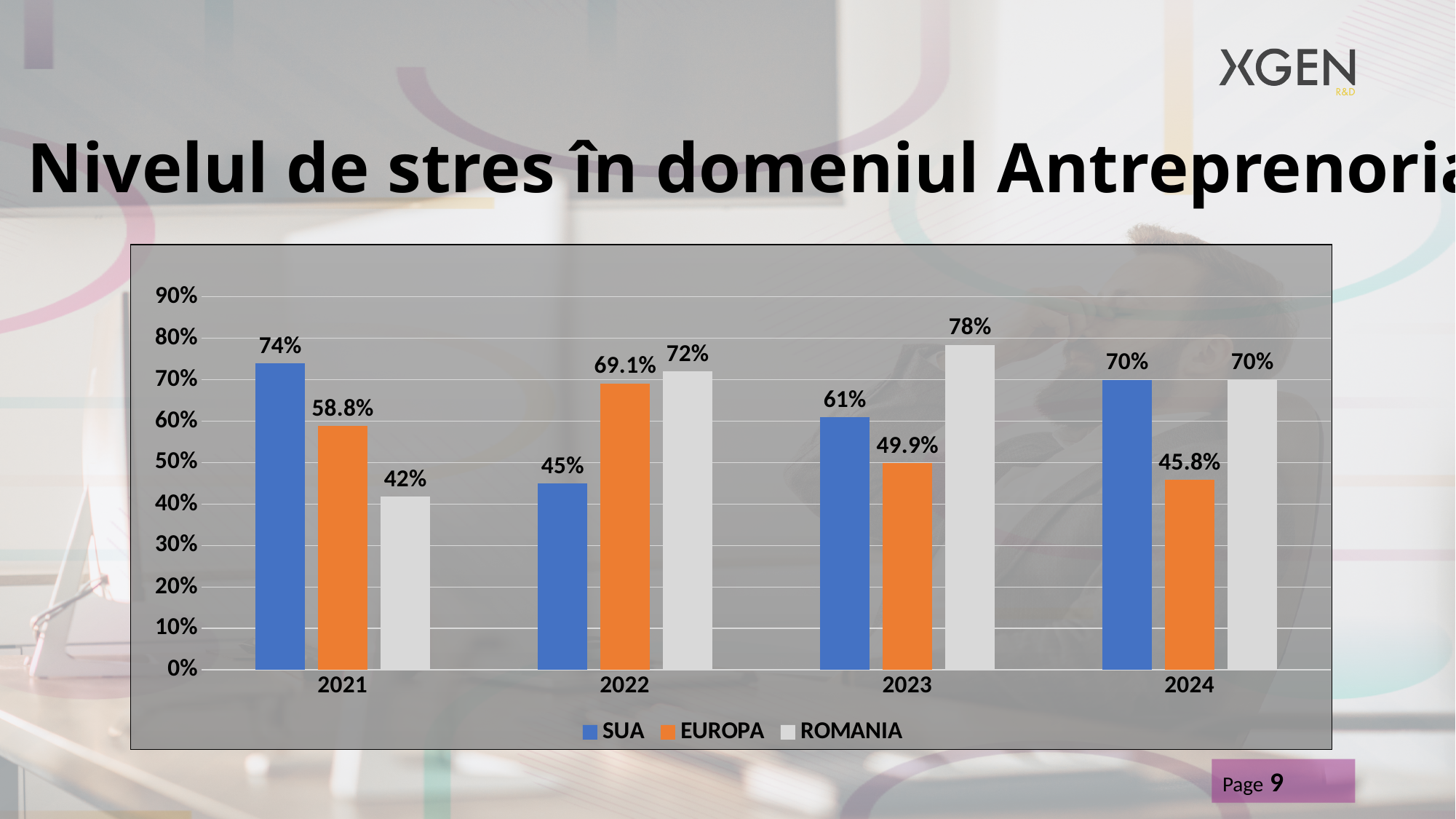
In which year is the SUA value lowest? 2022 What is the value for SUA in 2021? 74% What is the value for EUROPA in 2022? 69.1% Which colour represents EUROPA in the legend? Orange What kind of chart is shown on the slide? Bar chart What is the value for ROMANIA in 2023? 78% What is the difference between the SUA value in 2021 and the SUA value in 2022? 29% In which year is the ROMANIA value highest? 2023 How many series does the legend list? 3 What is the value for EUROPA in 2024? 45.8% How many years are shown on the x axis? 4 Which is larger in 2023, the SUA value or the EUROPA value? SUA